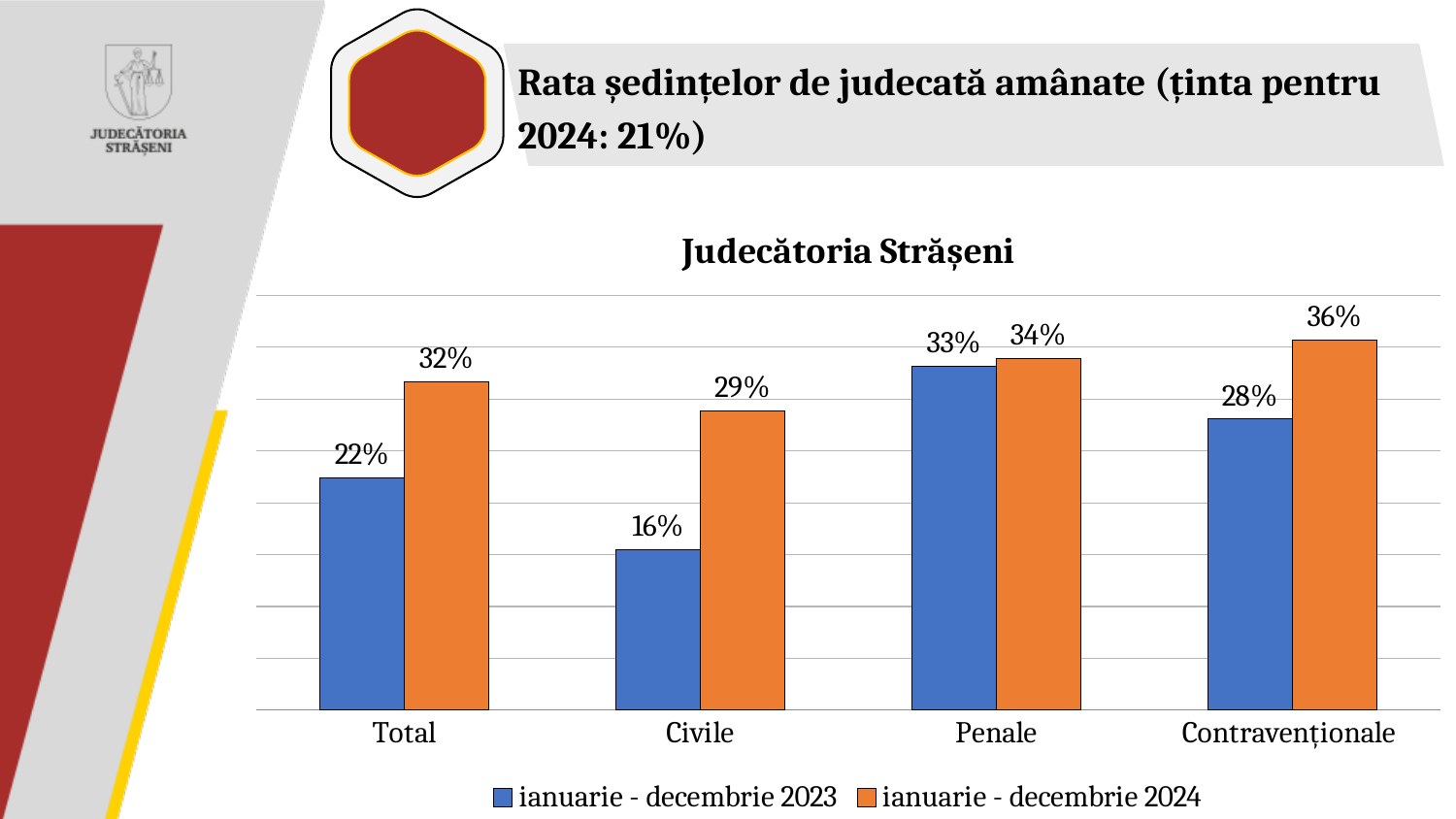
What is the value for Total in the ianuarie - decembrie 2024 series? 32% What is the value for Contravenționale in the ianuarie - decembrie 2024 series? 36% What is the difference between the 2024 and 2023 values for Total? 10% How many categories are shown on the x axis? 4 What is the difference between the 2024 and 2023 values for Civile? 13% What is the title of the chart? Judecătoria Strășeni What is the value for Civile in the ianuarie - decembrie 2023 series? 16% What kind of chart is shown on the slide? bar chart How many series does the legend list? 2 Which category has the highest value in the ianuarie - decembrie 2024 series? Contravenționale Which category has the lowest value in the ianuarie - decembrie 2023 series? Civile Which is larger for Penale: the ianuarie - decembrie 2023 value or the ianuarie - decembrie 2024 value? ianuarie - decembrie 2024